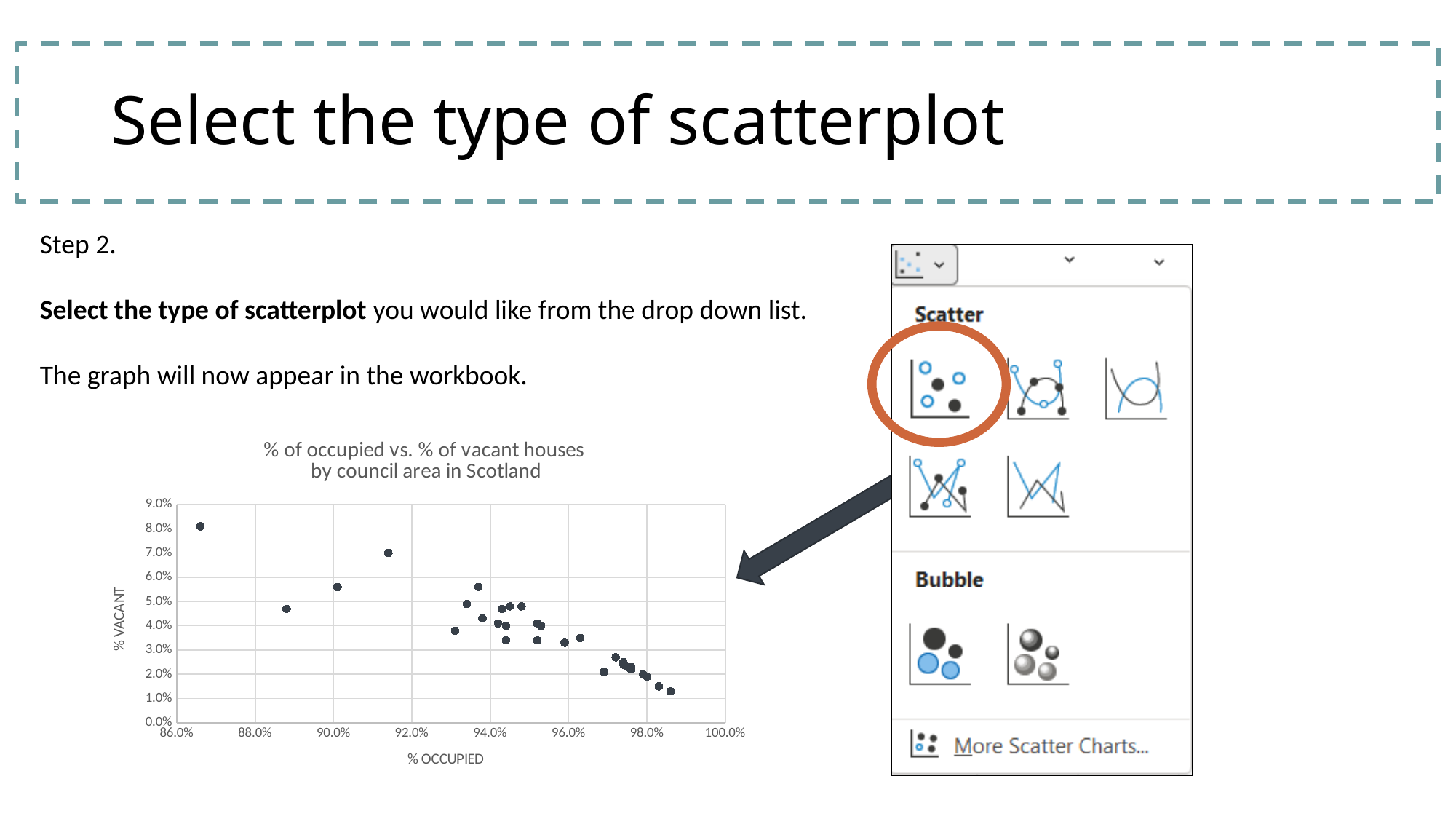
Which has the higher % vacant: the point with the lowest % occupied or the point with the highest % occupied? the point with the lowest % occupied Is the % vacant value for the point at about 90.0% occupied greater or less than 5.0%? greater Is the % vacant value for the point with the lowest % occupied greater or less than 7.0%? greater Is the % vacant value for the point at about 88.8% occupied greater or less than 6.0%? less What is the title of the chart on the slide? % of occupied vs. % of vacant houses by council area in Scotland As % occupied increases along the x axis, do the % vacant values generally rise or fall? fall What kind of chart is shown on the slide? scatter plot What is the label of the horizontal axis of the chart? % OCCUPIED